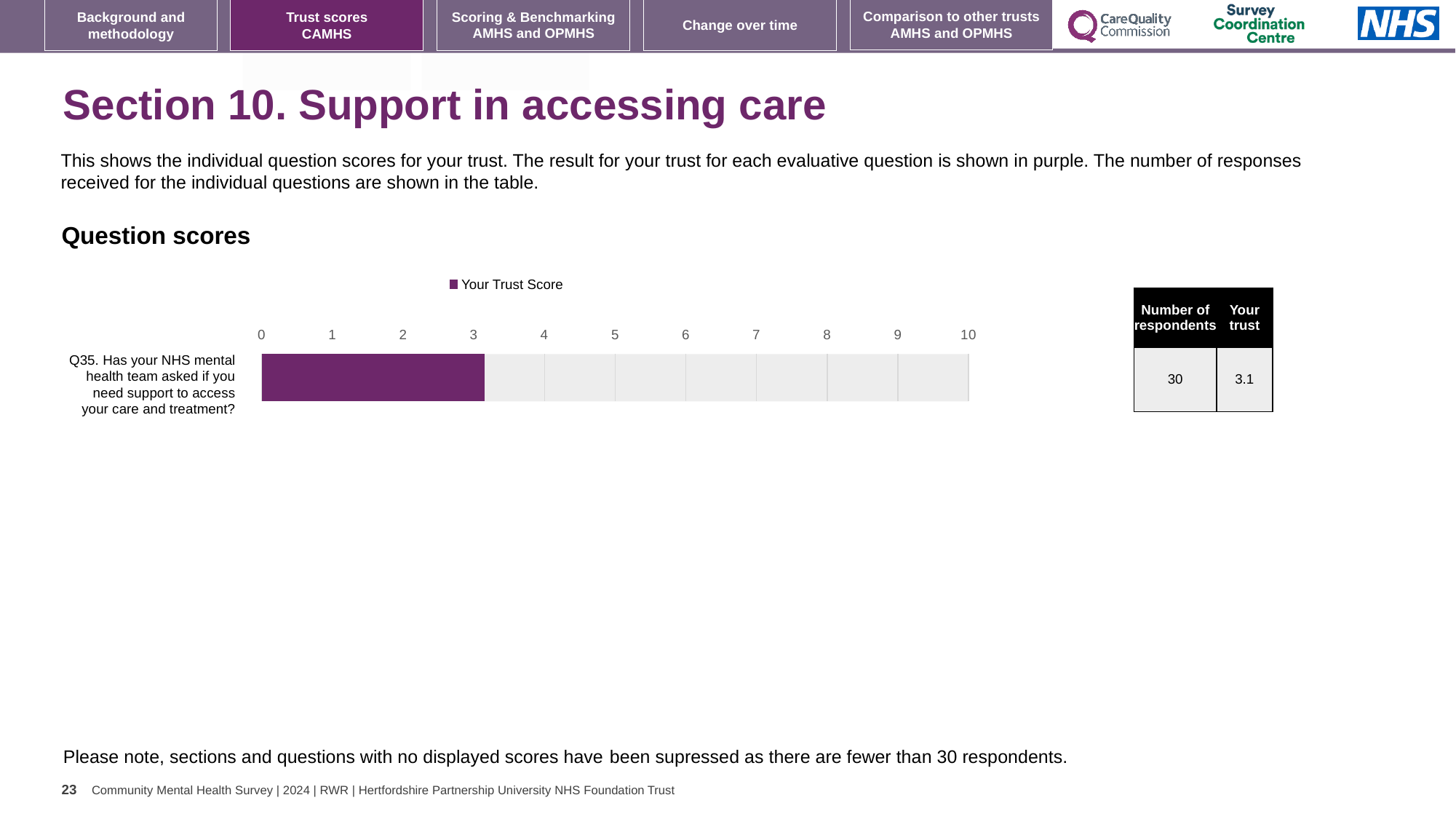
Is the trust score for Q35 greater or less than 2? greater What is the maximum value shown on the x axis of the 'Question scores' chart? 10 What is the name of the series shown in the legend of the 'Question scores' chart? Your Trust Score How many respondents answered Q35 according to the table next to the chart? 30 What type of chart is shown under 'Question scores'? bar chart How many questions (categories) are plotted in the 'Question scores' chart? 1 How many series does the legend of the 'Question scores' chart list? 1 Is the trust score for Q35 greater or less than 5? less What is the trust score for Q35 (Has your NHS mental health team asked if you need support to access your care and treatment?) as shown in the table? 3.1 Is the trust score for Q35 greater or less than 4? less